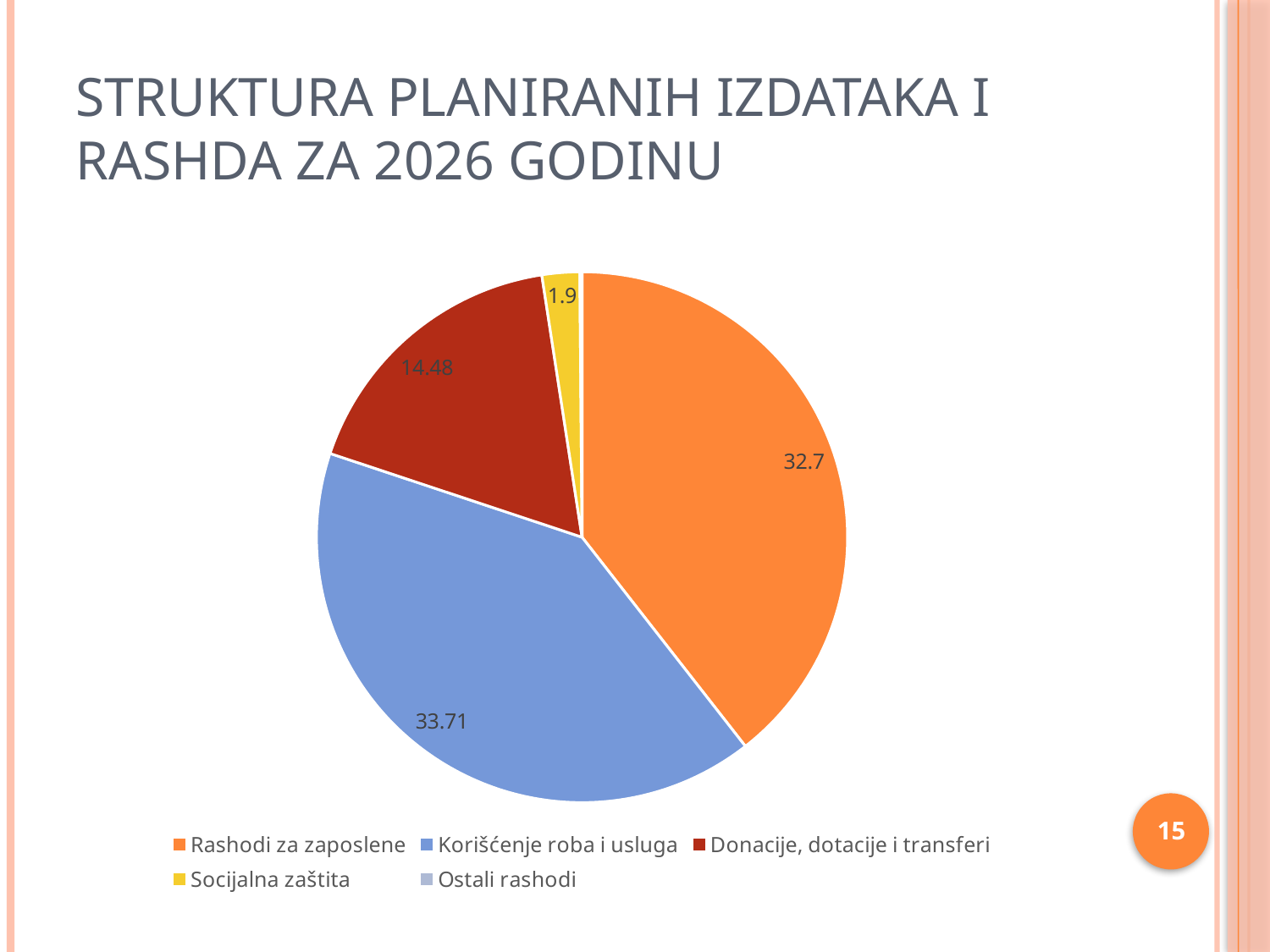
Which category has the smallest printed value in the pie chart? Socijalna zaštita What is the value shown for Korišćenje roba i usluga? 33.71 What is the value shown for Socijalna zaštita? 1.9 What type of chart is shown on the slide? pie chart Which is larger, the value for Rashodi za zaposlene or the value for Korišćenje roba i usluga? Korišćenje roba i usluga How many categories are listed in the chart legend? 5 What is the difference between the values for Rashodi za zaposlene and Donacije, dotacije i transferi? 18.22 What is the value shown for Donacije, dotacije i transferi? 14.48 What is the difference between the values for Korišćenje roba i usluga and Rashodi za zaposlene? 1.01 What colour is the slice for Socijalna zaštita? yellow Which category has the largest value in the pie chart? Korišćenje roba i usluga What is the value shown for Rashodi za zaposlene? 32.7